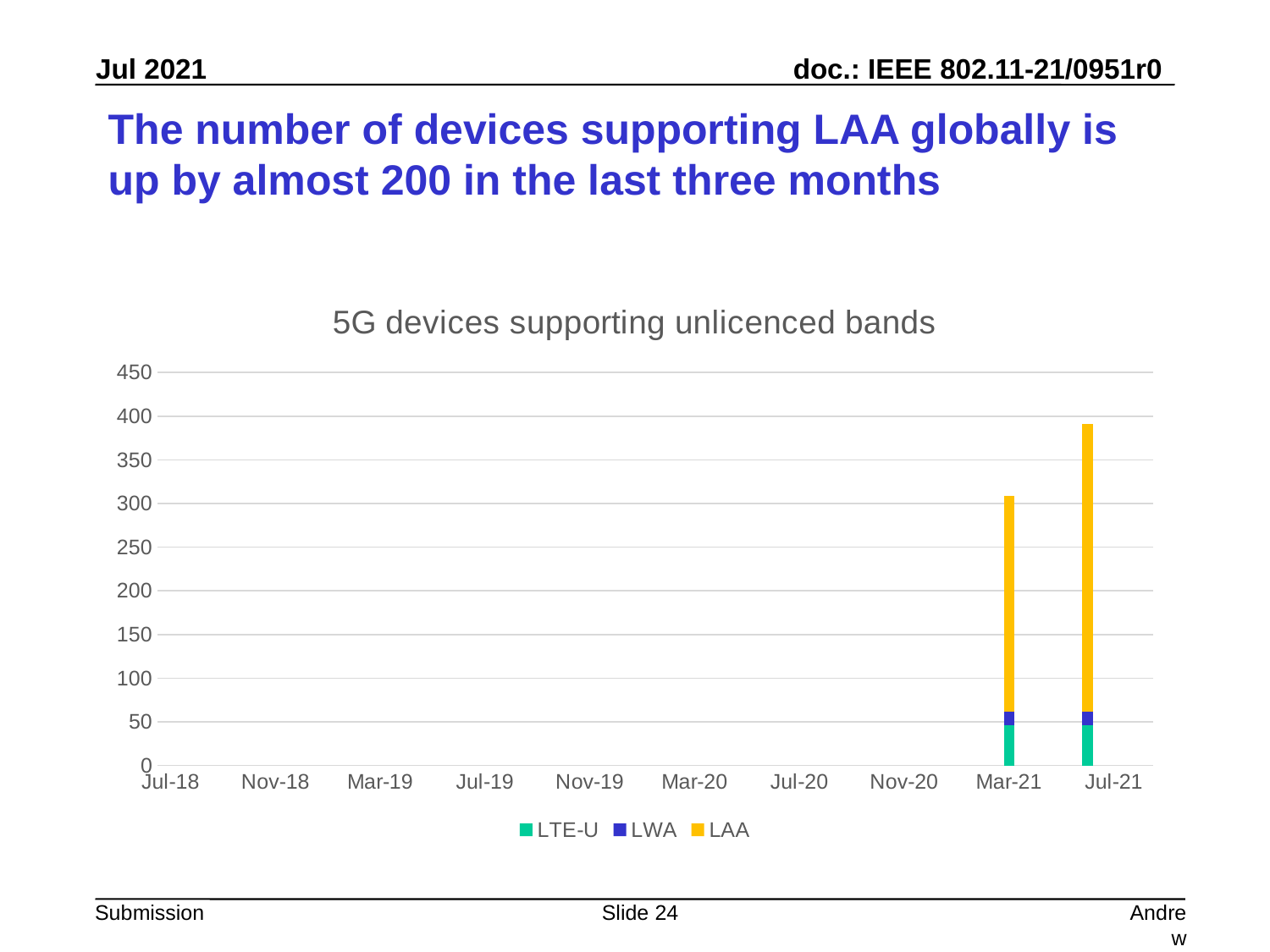
Which date has the tallest stacked bar? Jul-21 Is the total value for Jul-21 greater or less than 350? greater Which series makes up the largest part of the Jul-21 bar? LAA Is the total value for Mar-21 greater or less than 250? greater What kind of chart is shown on the slide? stacked bar chart Which is larger, the total bar for Mar-21 or the total bar for Jul-21? Jul-21 What is the title of the chart? 5G devices supporting unlicenced bands Is the total value for Mar-21 greater or less than 350? less How many series does the legend list? 3 How many date categories are shown on the x axis? 10 Do the stacked bar totals rise or fall from Mar-21 to Jul-21? rise Which series are listed in the legend? LTE-U, LWA, LAA